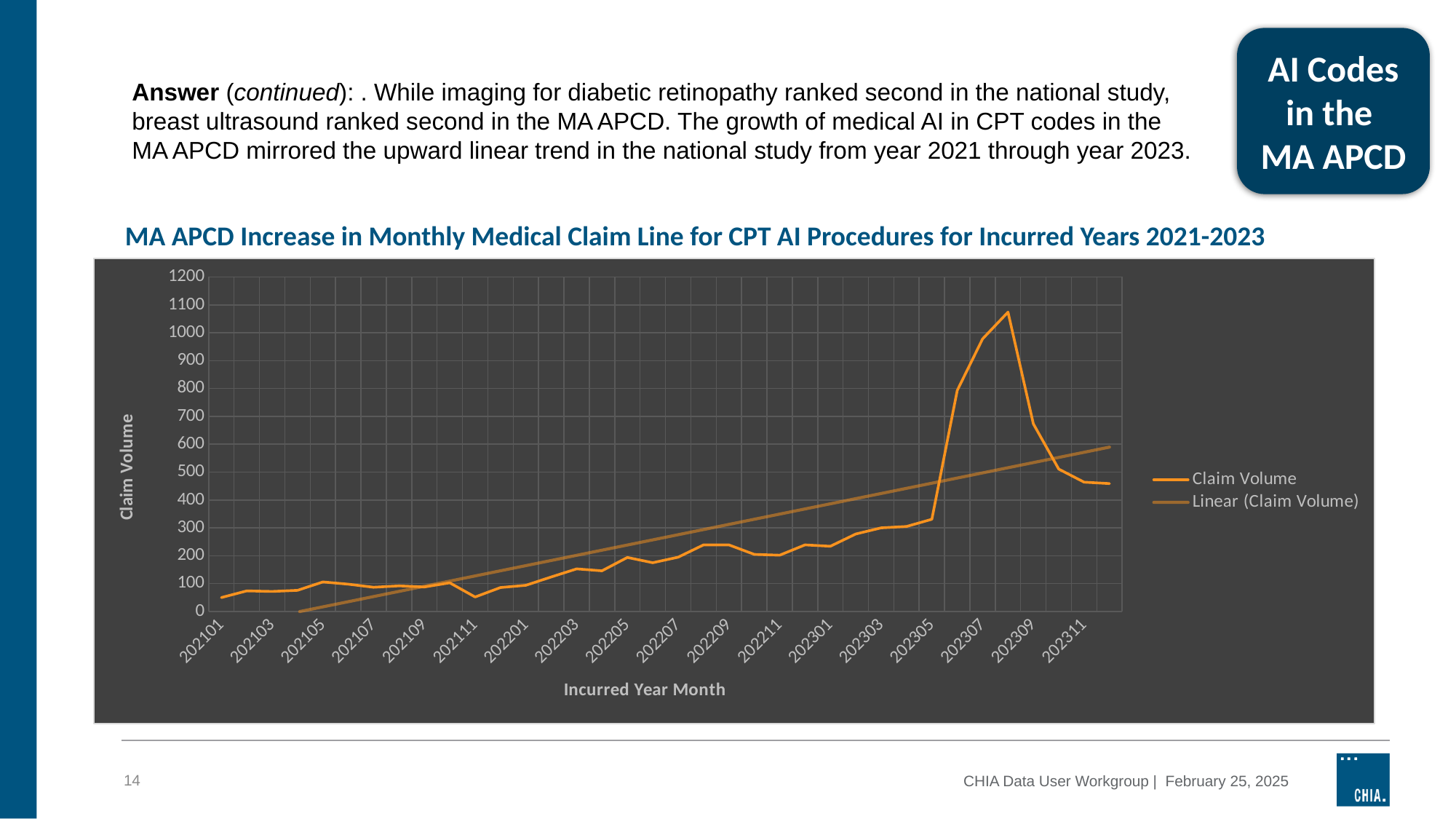
Which has the larger Claim Volume, 202305 or 202307? 202307 Is the Claim Volume for 202305 greater or less than 400? less What is the title of the chart? MA APCD Increase in Monthly Medical Claim Line for CPT AI Procedures for Incurred Years 2021-2023 What are the two entries in the chart legend? Claim Volume and Linear (Claim Volume) How many series does the chart legend list? 2 Is the Claim Volume for 202309 greater or less than 600? greater Which has the larger Claim Volume, 202101 or 202311? 202311 What kind of chart is shown on the slide? Line chart Is the Claim Volume for 202101 greater or less than 100? less Does the Linear (Claim Volume) trend line rise or fall from left to right? Rises